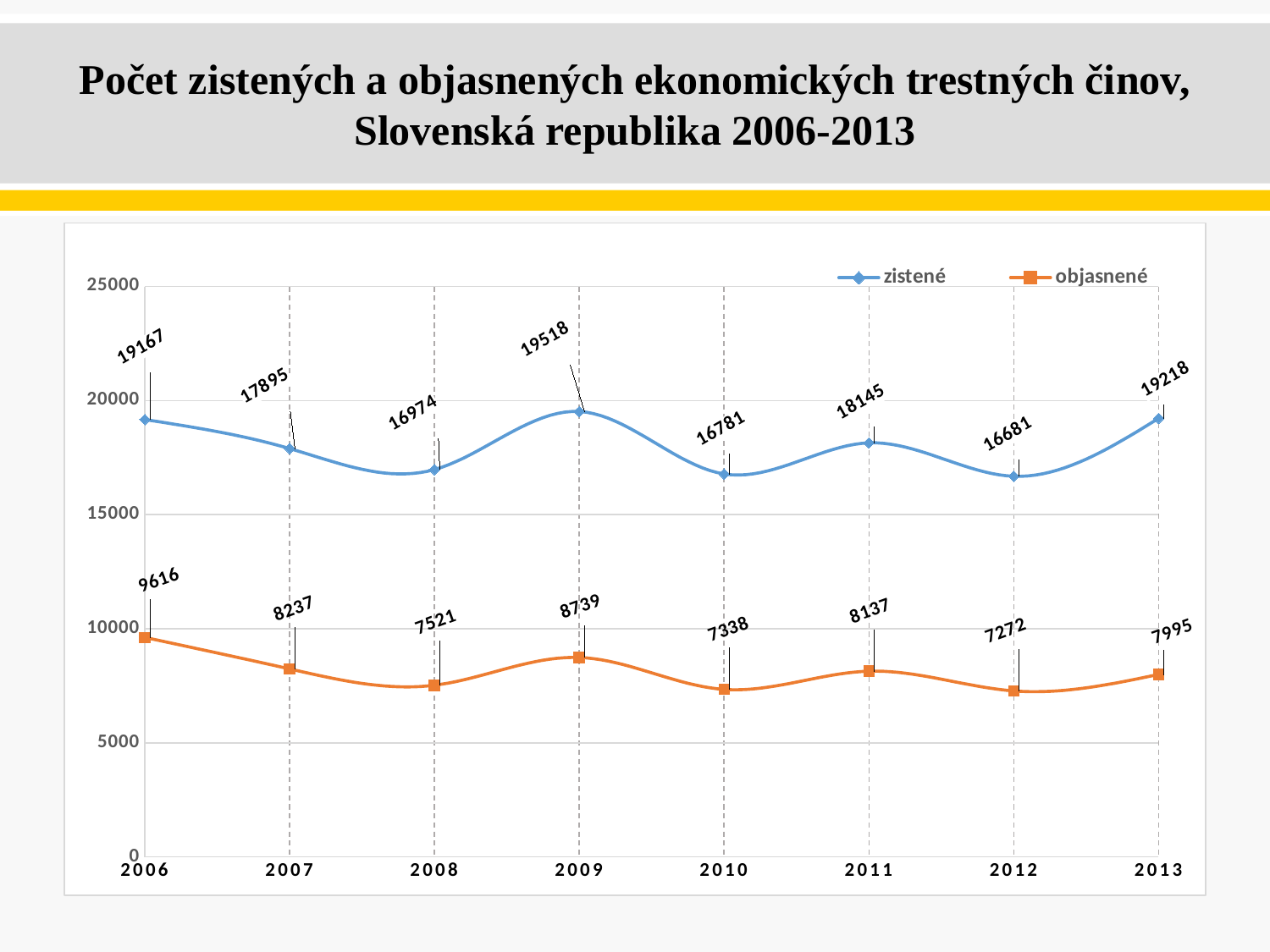
What is the value for zistené in 2009? 19518 How many series does the legend list? 2 How many years are shown on the x axis? 8 Does the zistené series rise or fall from 2006 to 2008? fall In which year is the zistené series highest? 2009 What is the value for objasnené in 2012? 7272 What kind of chart is shown on the slide? line chart What is the value for objasnené in 2006? 9616 Is the value for objasnené in 2011 greater or less than 10000? less What is the difference between zistené and objasnené in 2013? 11223 Which is larger, the zistené value in 2006 or in 2013? 2013 In which year is the objasnené series lowest? 2012